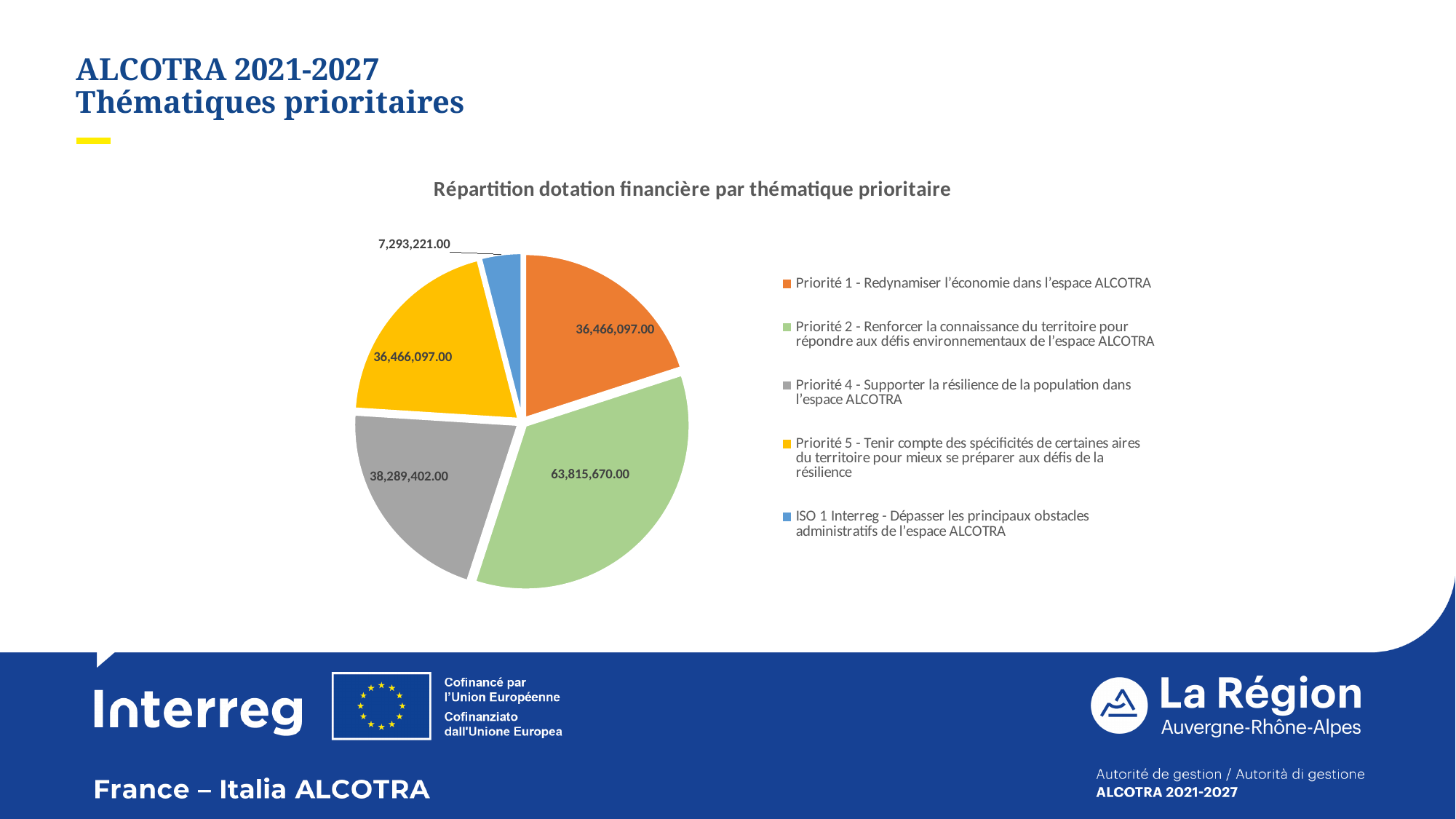
Which colour represents Priorité 5 in the pie chart? Yellow What type of chart is shown on the slide? Pie chart Which category has the smallest slice of the pie? ISO 1 Interreg - Dépasser les principaux obstacles administratifs de l'espace ALCOTRA What is the value for ISO 1 Interreg - Dépasser les principaux obstacles administratifs? 7,293,221.00 How many slices does the pie chart have? 5 What is the value for Priorité 2 - Renforcer la connaissance du territoire? 63,815,670.00 What is the value for Priorité 4 - Supporter la résilience de la population? 38,289,402.00 What share of the total allocation does Priorité 2 represent? 35% What is the difference between the values for Priorité 2 and Priorité 4? 25,526,268.00 What is the title of the chart? Répartition dotation financière par thématique prioritaire Which is larger, the value for Priorité 4 or the value for Priorité 1? Priorité 4 Which priority has the largest share of the financial allocation? Priorité 2 - Renforcer la connaissance du territoire pour répondre aux défis environnementaux de l'espace ALCOTRA